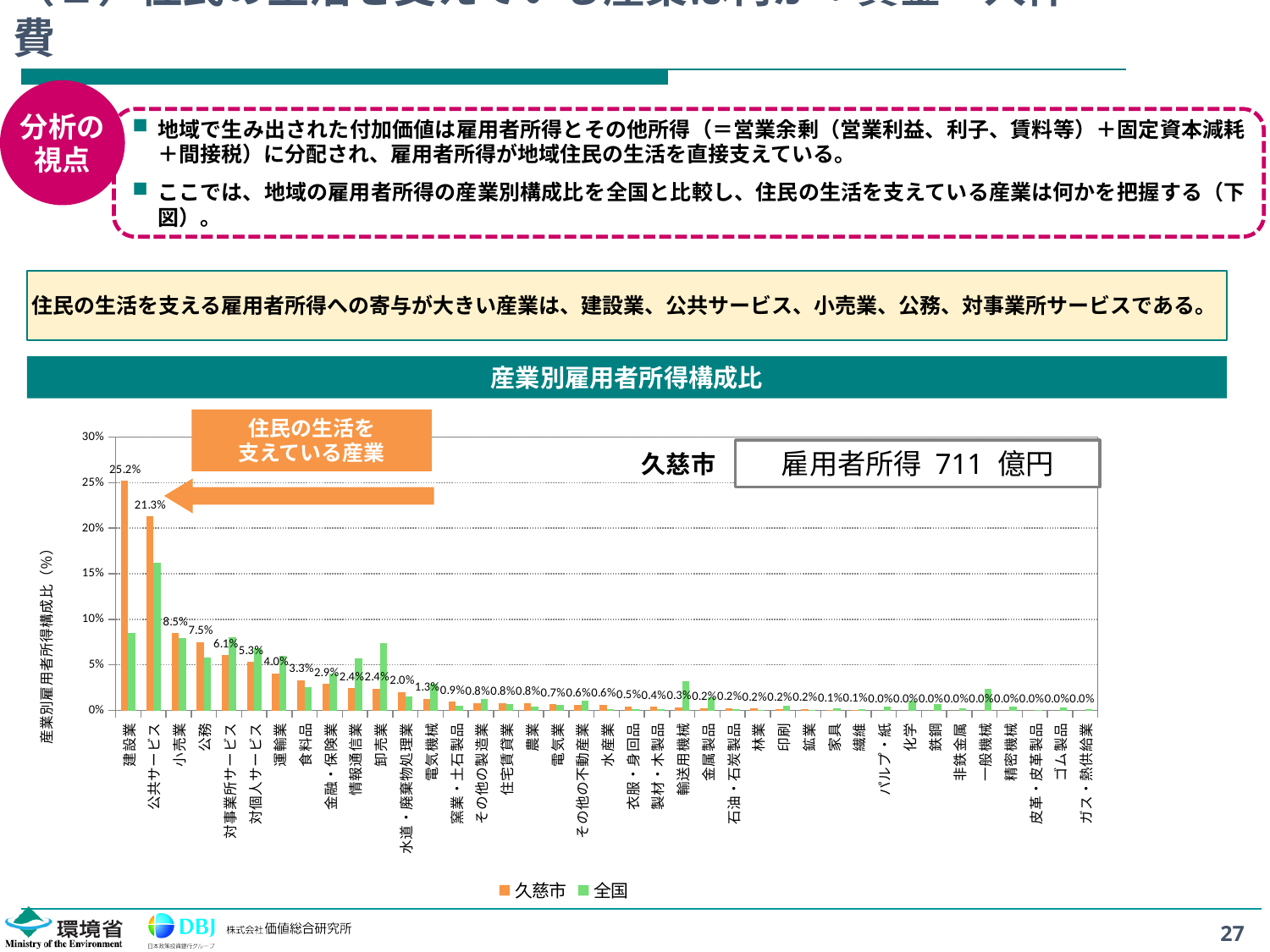
For 卸売業, which series has the larger value, 久慈市 or 全国? 全国 Is the 全国 value for 建設業 greater or less than 10%? less What is the 久慈市 value for 建設業 in the 産業別雇用者所得構成比 chart? 25.2% What is the 久慈市 value for 公共サービス? 21.3% What kind of chart is shown on the slide? Bar chart What is the difference between the 久慈市 values for 建設業 and 公共サービス? 3.9 percentage points Which industry has the highest 久慈市 value in the chart? 建設業 For 建設業, which series has the larger value, 久慈市 or 全国? 久慈市 What is the 久慈市 value for 小売業? 8.5% What is the 久慈市 value for 公務? 7.5% How many series does the legend of the chart list? 2 Is the 全国 value for 公共サービス greater or less than 15%? greater